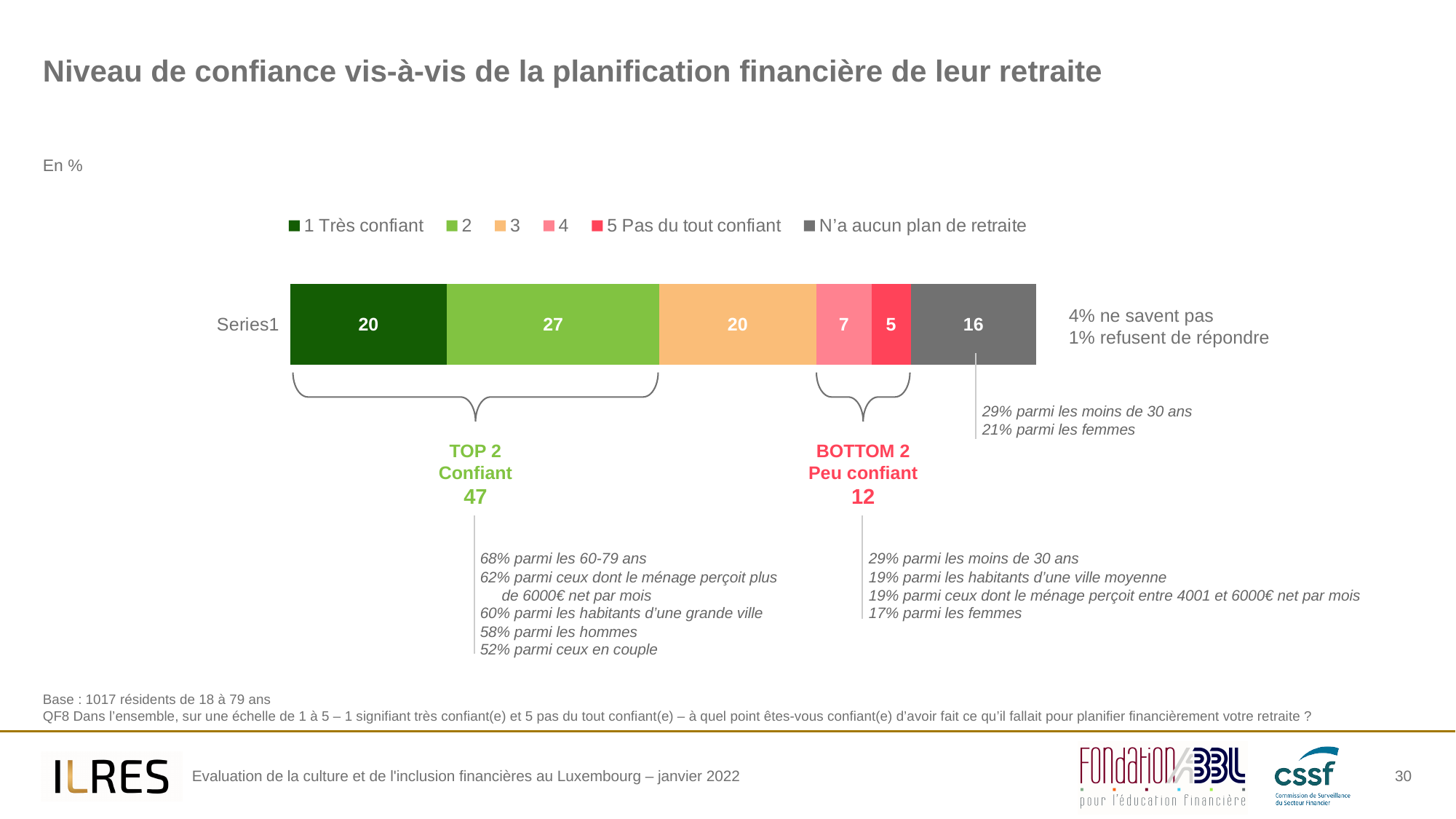
What is the total of all segments in the stacked bar? 95 What is the TOP 2 (Confiant) value shown below the bar? 47 What value is shown for the segment "5 Pas du tout confiant"? 5 What value is shown for the segment "2"? 27 What is the difference between the value for segment "2" and the value for segment "4"? 20 Which is larger, the value for "N'a aucun plan de retraite" or the value for "4"? N'a aucun plan de retraite What value is shown for the segment "N'a aucun plan de retraite"? 16 What value is shown for the segment "1 Très confiant"? 20 How many series does the legend list? 6 What kind of chart is shown on the slide? Stacked bar chart Which segment of the stacked bar has the highest value? 2 Which segment of the stacked bar has the lowest value? 5 Pas du tout confiant